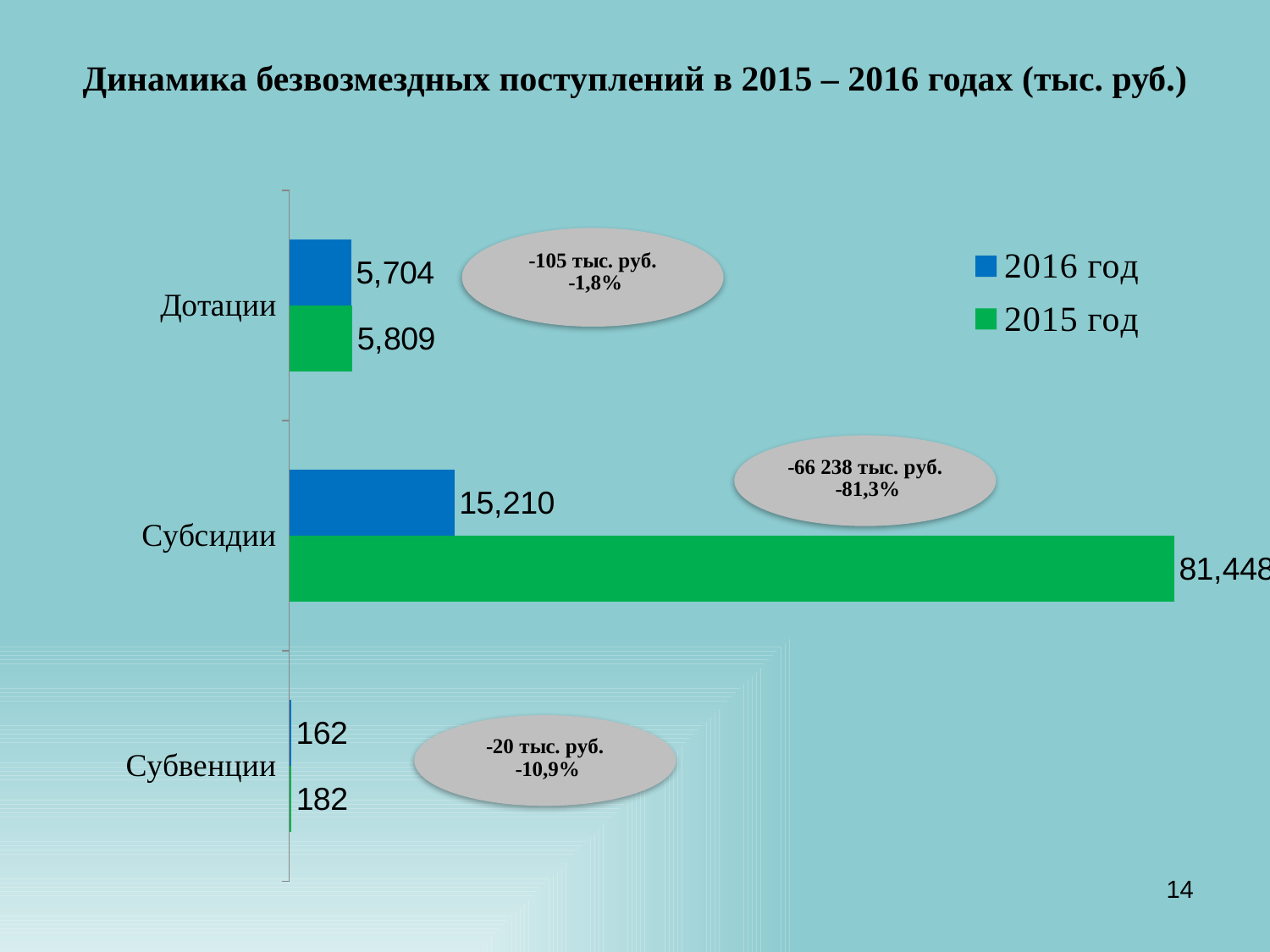
What is the difference between the 2015 год and 2016 год values for Дотации? 105 What is the value for Дотации in the 2016 год series? 5,704 What is the value for Субсидии in the 2015 год series? 81,448 What kind of chart is shown on the slide? Bar chart How many series does the legend list? 2 Which is larger for Субсидии: the 2016 год value or the 2015 год value? 2015 год What is the value for Субвенции in the 2015 год series? 182 What is the value for Субвенции in the 2016 год series? 162 What is the difference between the 2015 год and 2016 год values for Субсидии? 66,238 How many categories are shown on the chart? 3 Which category has the lowest value in the 2016 год series? Субвенции Which category has the highest value in the 2015 год series? Субсидии